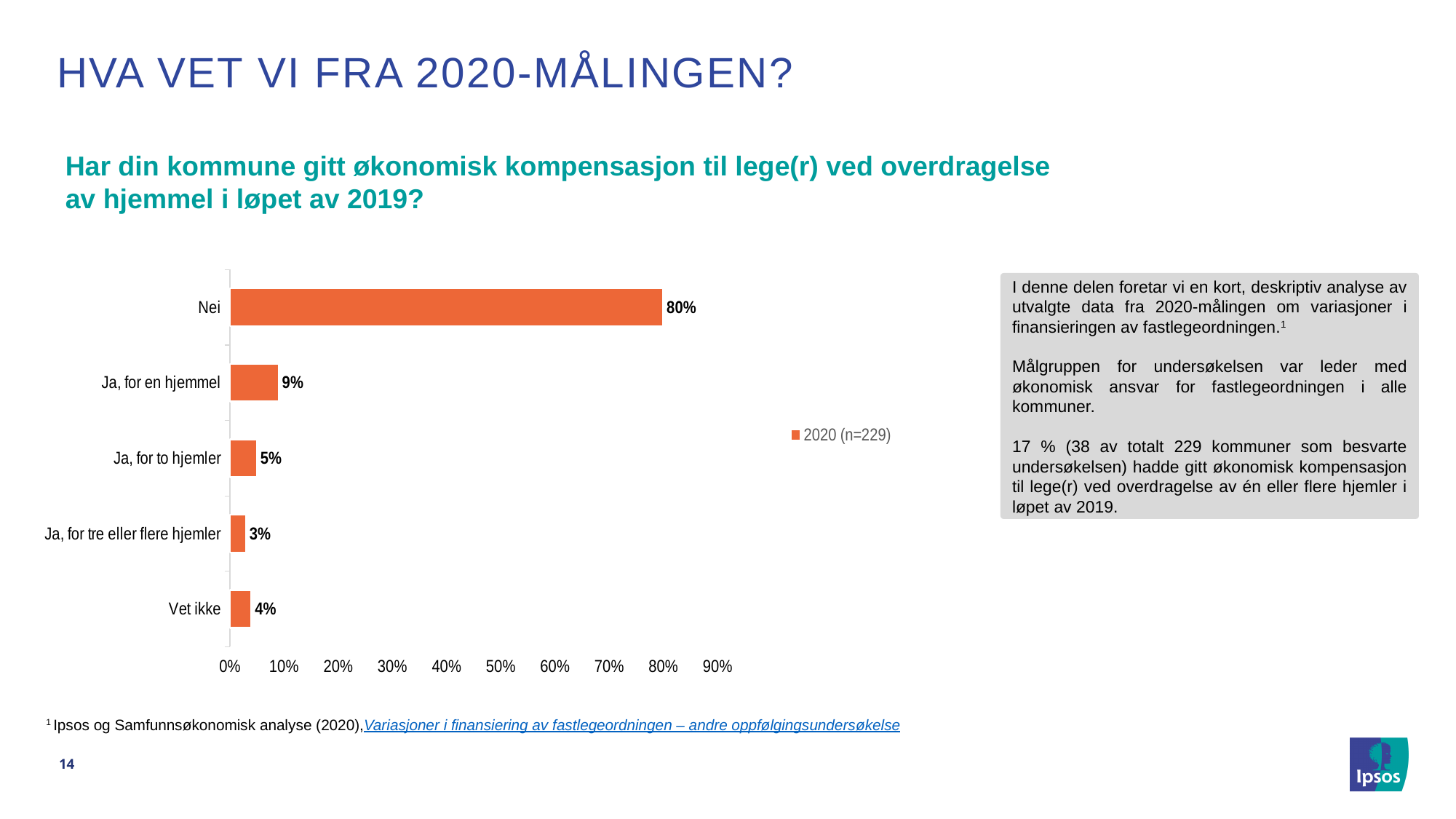
What is the value for "Ja, for en hjemmel"? 9% What is the value for "Vet ikke"? 4% Which category has the highest value? Nei How many categories are shown in the chart? 5 Which is larger, the value for "Ja, for to hjemler" or the value for "Vet ikke"? Ja, for to hjemler Is the value for "Nei" greater or less than 70%? greater What is the difference between the values for "Nei" and "Ja, for en hjemmel"? 71% What is the value for "Ja, for to hjemler"? 5% What kind of chart is shown on the slide? bar chart Which category has the lowest value? Ja, for tre eller flere hjemler What is the legend entry for the series in the chart? 2020 (n=229) What is the value for "Nei"? 80%